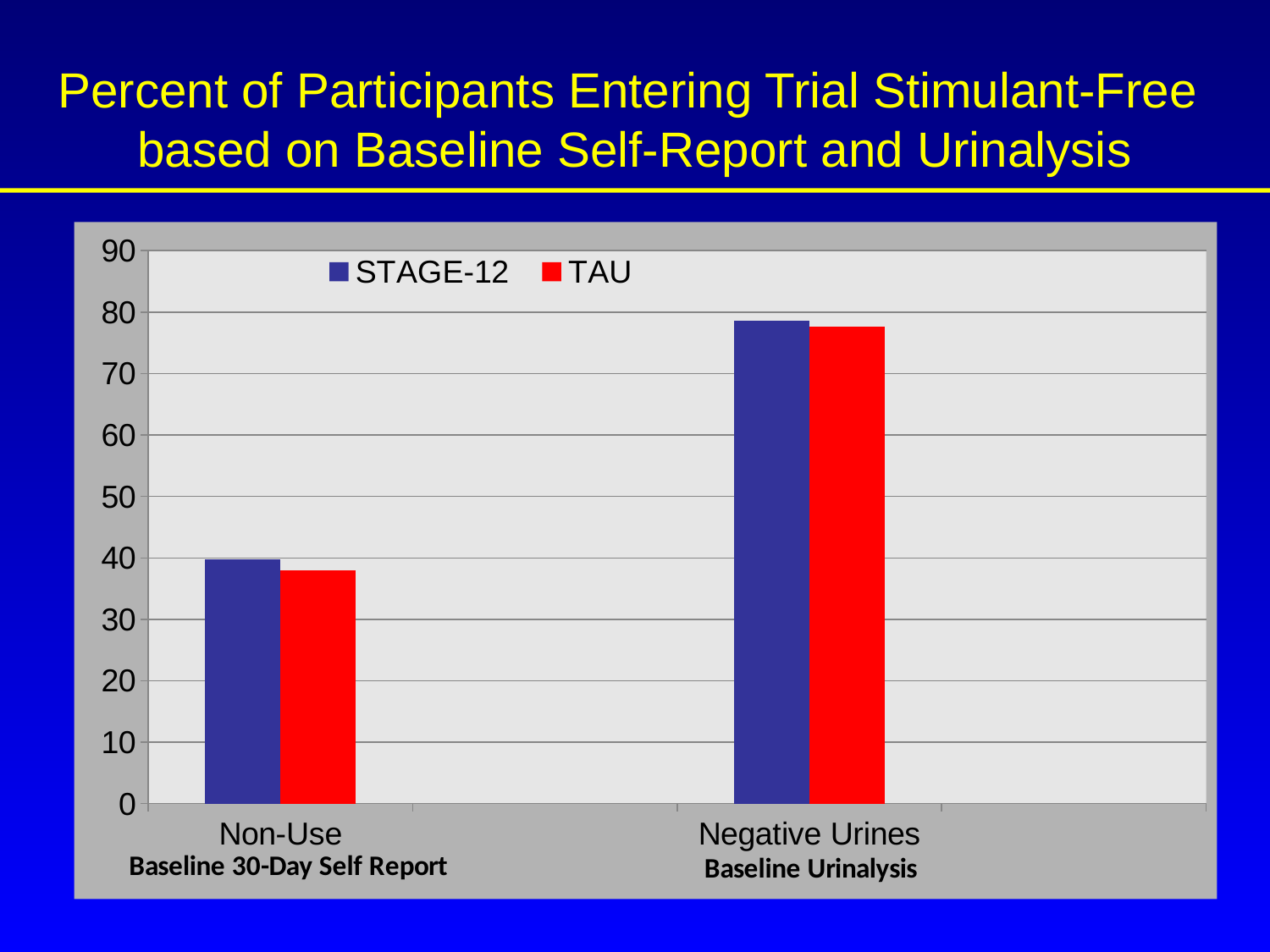
Is the TAU value for Non-Use greater or less than 30? greater For the TAU series, which category has the lowest value? Non-Use Is the STAGE-12 value for Non-Use greater or less than 50? less For the STAGE-12 series, which category has the higher value: Non-Use or Negative Urines? Negative Urines Is the STAGE-12 value for Negative Urines greater or less than 70? greater Which series is shown in red in the legend? TAU How many series does the legend list? 2 In the Non-Use category, which series has the larger value: STAGE-12 or TAU? STAGE-12 What kind of chart is shown on the slide? bar chart How many categories are shown on the x axis? 2 What is the title of the chart on the slide? Percent of Participants Entering Trial Stimulant-Free based on Baseline Self-Report and Urinalysis